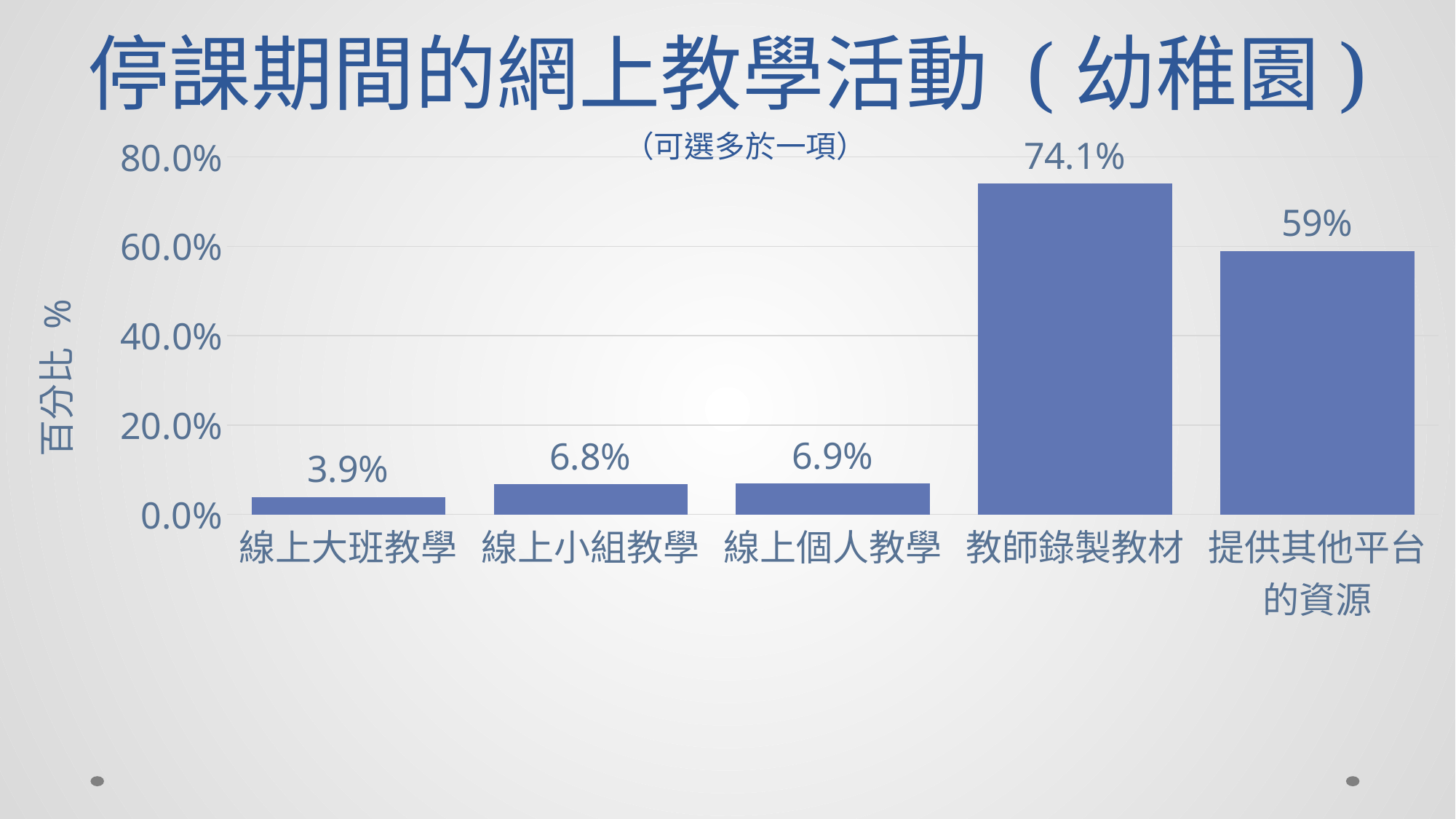
What is the value for 線上大班教學? 3.9% How many categories are shown in the chart? 5 Which category has the lowest value? 線上大班教學 What is the value for 提供其他平台的資源? 59% What is the value for 教師錄製教材? 74.1% Which category has the highest value? 教師錄製教材 What is the difference between the values for 教師錄製教材 and 提供其他平台的資源? 15.1% What is the label on the vertical axis of the chart? 百分比 % Which is larger, the value for 線上小組教學 or the value for 線上大班教學? 線上小組教學 What kind of chart is shown on the slide? bar chart What is the value for 線上小組教學? 6.8% Is the value for 提供其他平台的資源 greater or less than 40.0%? greater